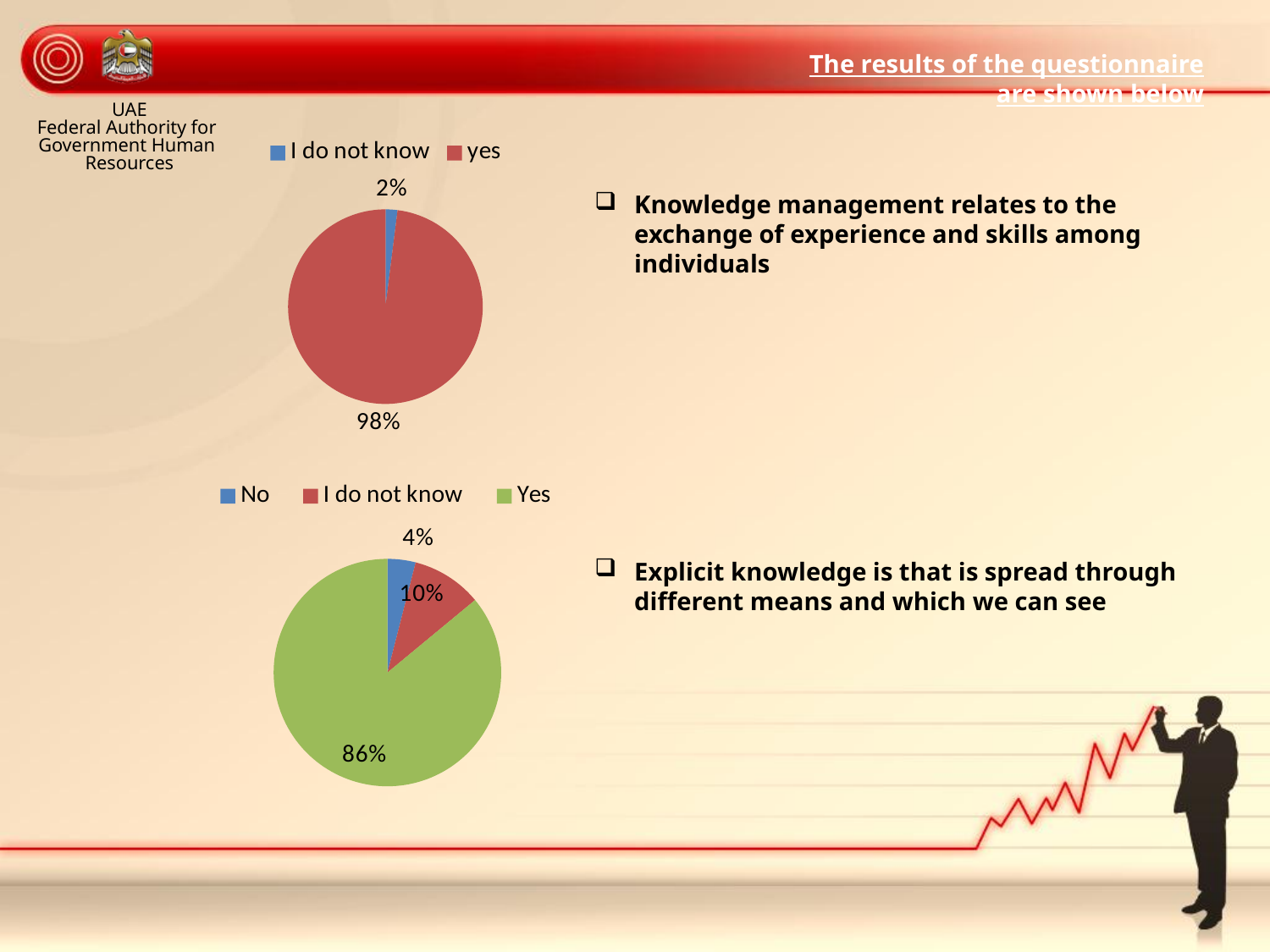
In the bottom pie chart, what percentage is shown for "Yes"? 86% In the bottom pie chart, which category has the smallest share? No In the bottom pie chart, what is the difference between the "Yes" share and the "I do not know" share? 76% In the bottom pie chart, which category has the largest share? Yes In the top pie chart, what percentage is shown for "yes"? 98% In the bottom pie chart, what percentage is shown for "I do not know"? 10% In the bottom pie chart, which is larger: "No" or "I do not know"? I do not know What type of chart is the top chart on the slide? Pie chart In the top pie chart, what percentage is shown for "I do not know"? 2% In the bottom pie chart, what percentage is shown for "No"? 4% How many categories does the legend of the bottom pie chart list? 3 In the top pie chart, what is the difference between the "yes" share and the "I do not know" share? 96%